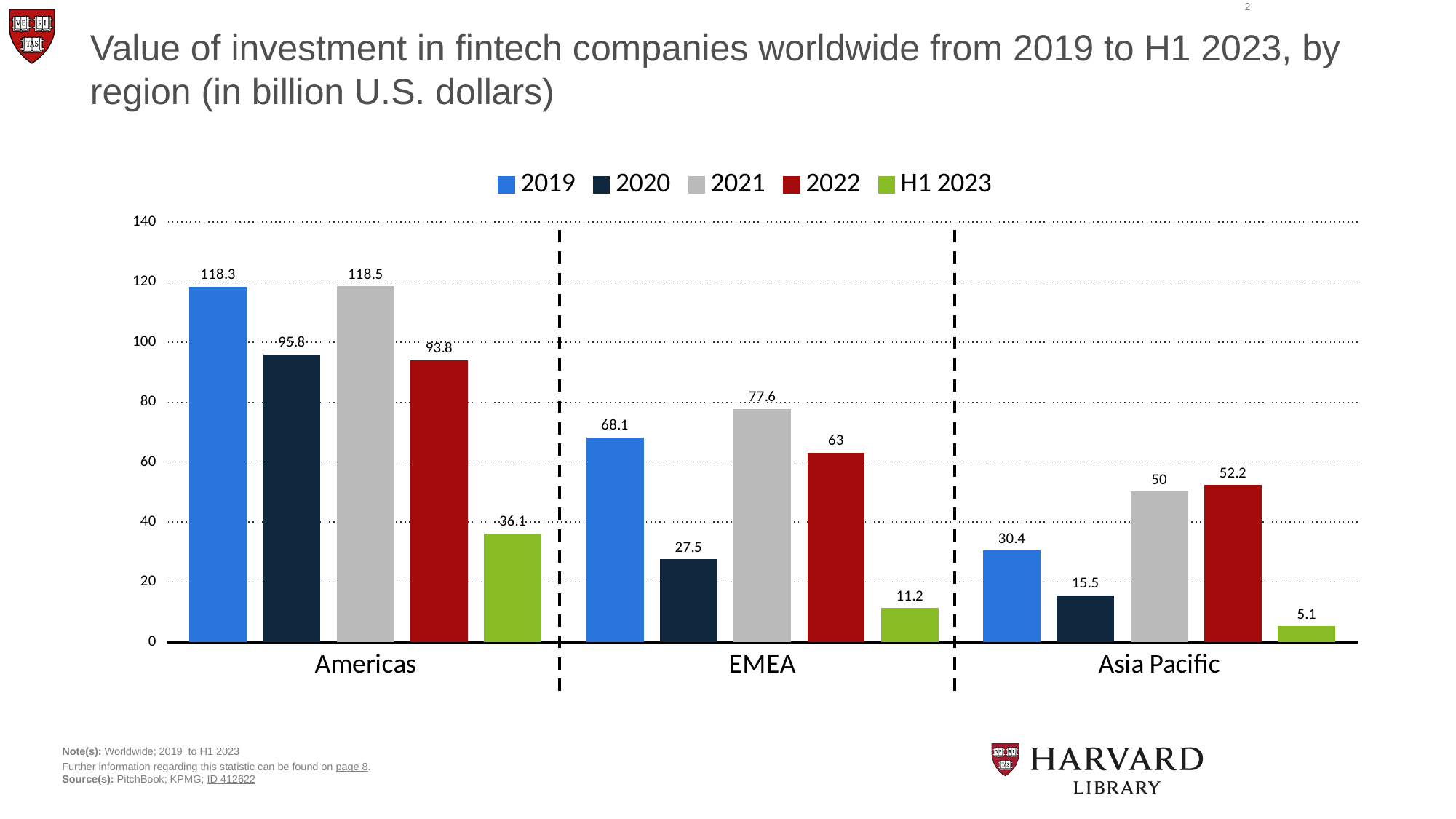
How many regions are shown on the x axis? 3 What is the value of fintech investment in EMEA in 2021? 77.6 What is the value of fintech investment in Asia Pacific in H1 2023? 5.1 How many series does the legend list? 5 What is the value of fintech investment in the Americas in 2019? 118.3 What kind of chart is shown on the slide? Bar chart Is the value for the Americas in 2020 greater or less than 80? greater Which colour represents the H1 2023 series in the legend? Green Which region has the highest value for 2022? Americas Which is larger for Asia Pacific: the 2021 value or the 2022 value? 2022 What is the difference between the 2021 and 2020 values for EMEA? 50.1 Which region has the lowest value for 2020? Asia Pacific